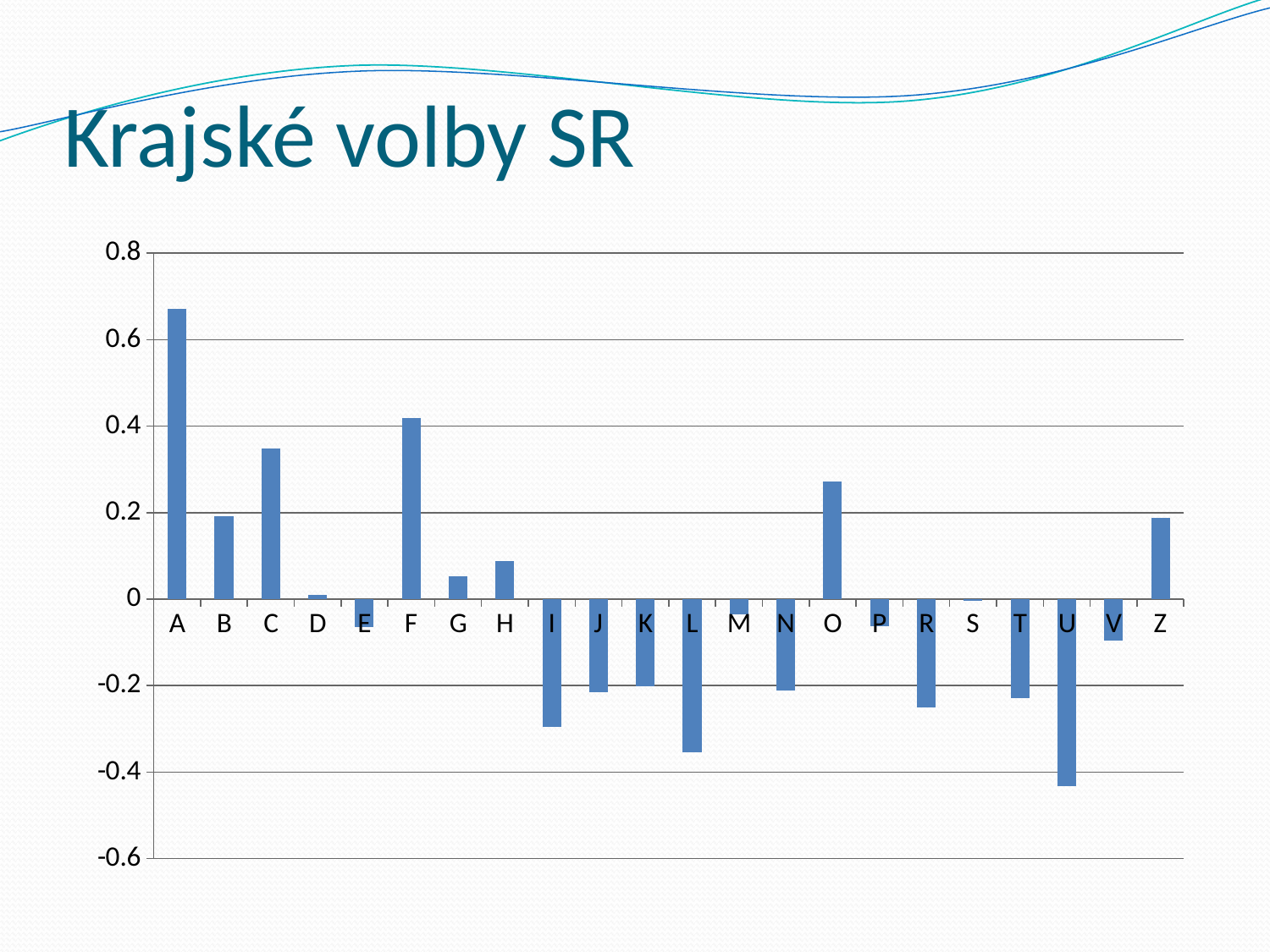
Which category has the lowest value in the chart? U Which category has the highest value in the chart? A What kind of chart is shown on the slide? bar chart Is the value for C greater or less than 0.4? less How many categories are plotted on the x axis of the chart? 22 Is the value for F greater or less than 0.4? greater Which has the larger value, O or Z? O What is the title of the slide containing the chart? Krajské volby SR Is the value for U greater or less than -0.4? less Which has the larger value, C or B? C